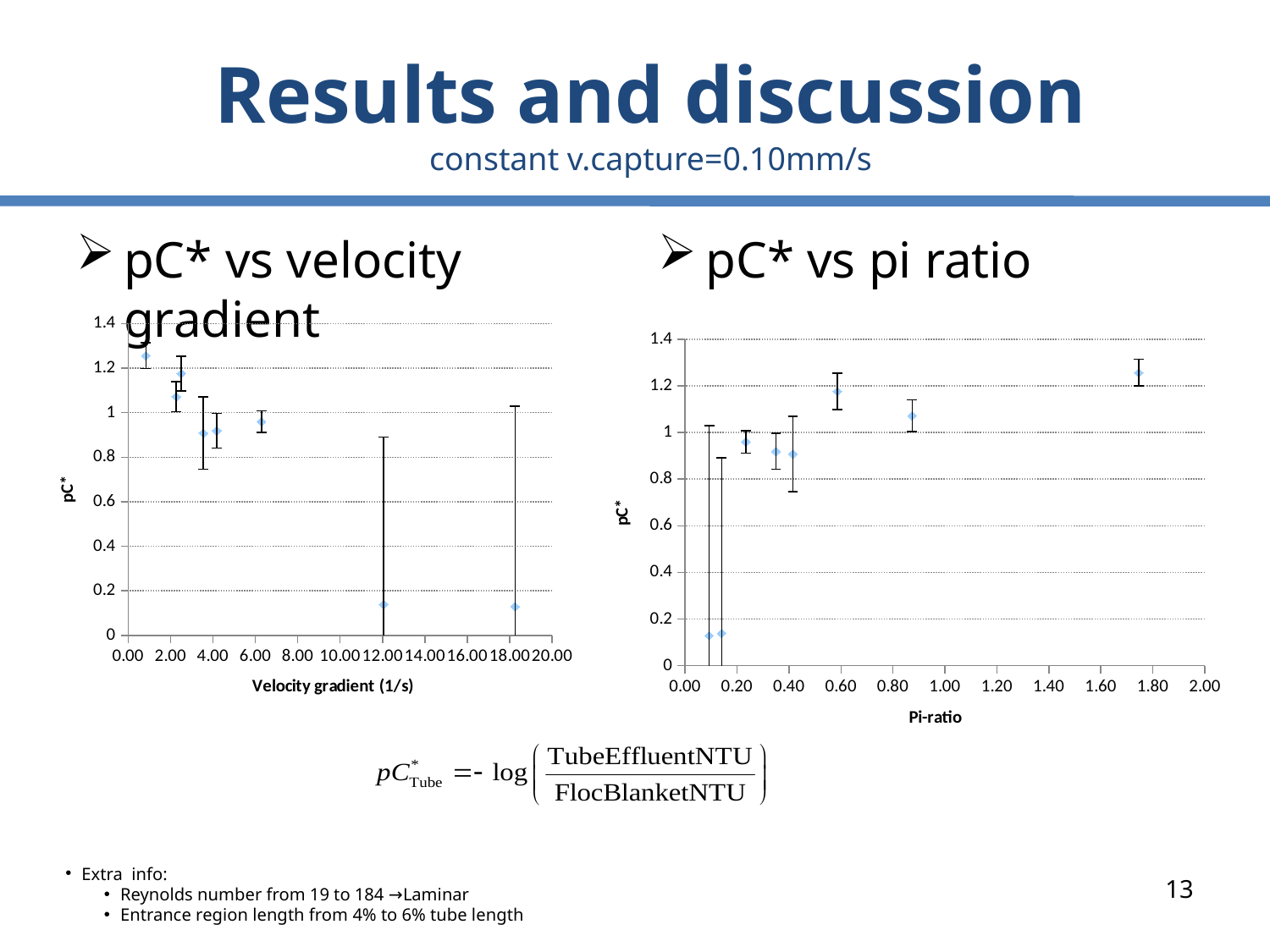
In the 'pC* vs pi ratio' chart on the right, do the pC* values generally rise or fall as the pi-ratio increases? rise What kind of chart is the 'pC* vs pi ratio' chart on the right? scatter chart In the 'pC* vs pi ratio' chart on the right, is the pC* value of the point with the largest pi-ratio greater or less than 1? greater In the 'pC* vs velocity gradient' chart on the left, do the pC* values generally rise or fall as the velocity gradient increases? fall In the 'pC* vs pi ratio' chart on the right, is the highest pC* value found at the lowest or the highest pi-ratio? highest How many data points are plotted in the 'pC* vs velocity gradient' chart on the left? 8 In the 'pC* vs velocity gradient' chart on the left, what is the label of the x axis? Velocity gradient (1/s) What kind of chart is the 'pC* vs velocity gradient' chart on the left? scatter chart In the 'pC* vs velocity gradient' chart on the left, is the pC* value of the point at a velocity gradient of about 12 greater or less than 0.2? less In the 'pC* vs velocity gradient' chart on the left, is the pC* value of the point with the smallest velocity gradient greater or less than 1? greater How many data points are plotted in the 'pC* vs pi ratio' chart on the right? 8 In the 'pC* vs pi ratio' chart on the right, what is the label of the x axis? Pi-ratio